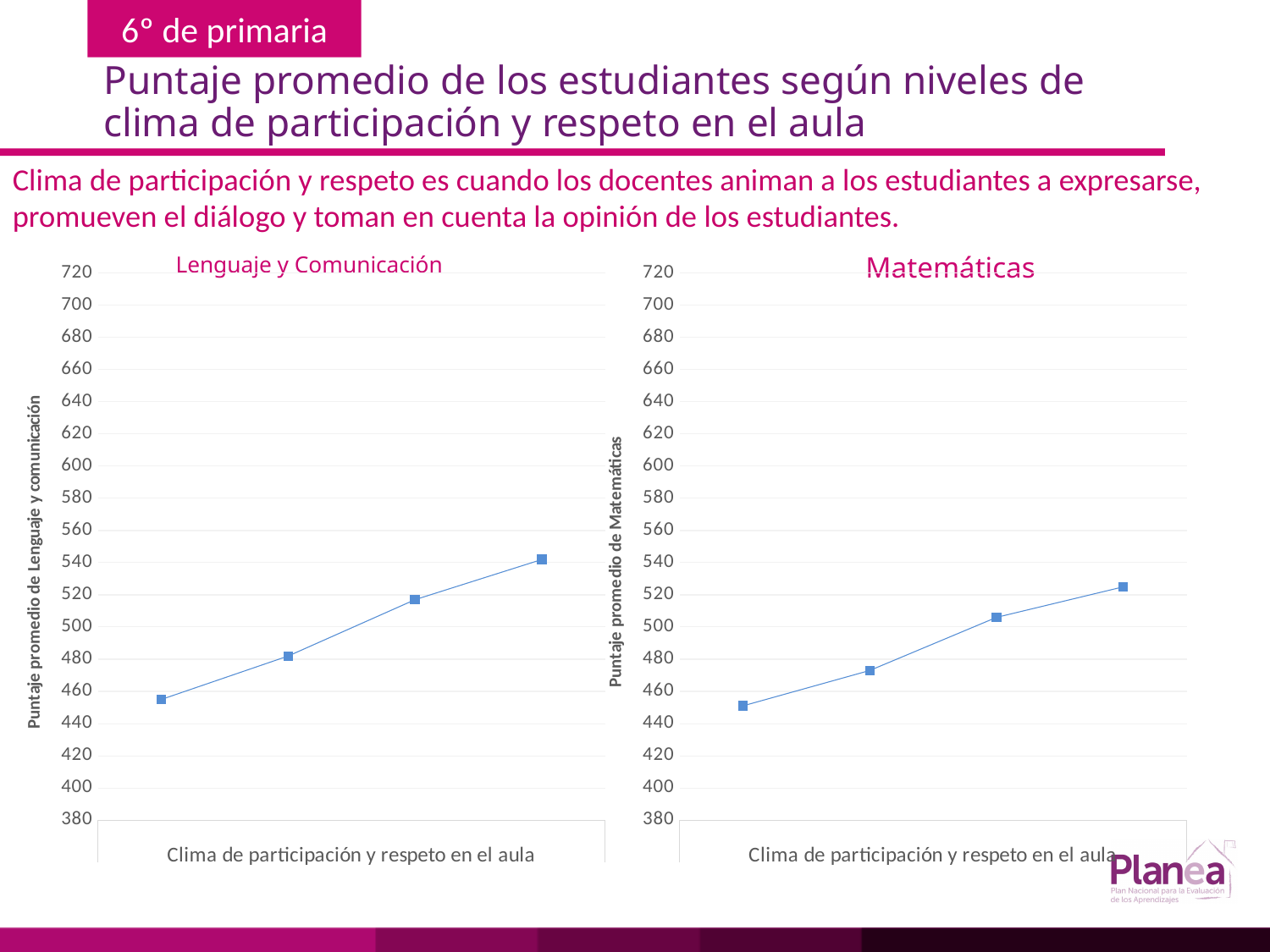
Which chart has the higher rightmost point, Lenguaje y Comunicación or Matemáticas? Lenguaje y Comunicación What kind of chart is the Lenguaje y Comunicación chart? line chart On the Lenguaje y Comunicación chart, is the value of the first (leftmost) point greater or less than 480? less What kind of chart is the Matemáticas chart? line chart How many data points are plotted on the Lenguaje y Comunicación chart? 4 On the Lenguaje y Comunicación chart, is the value of the last (rightmost) point greater or less than 520? greater On the Matemáticas chart, do the values rise or fall from left to right along the x axis? rise What is the x-axis label on the Matemáticas chart? Clima de participación y respeto en el aula On the Lenguaje y Comunicación chart, do the values rise or fall from left to right along the x axis? rise On the Matemáticas chart, is the value of the last (rightmost) point greater or less than 500? greater How many data points are plotted on the Matemáticas chart? 4